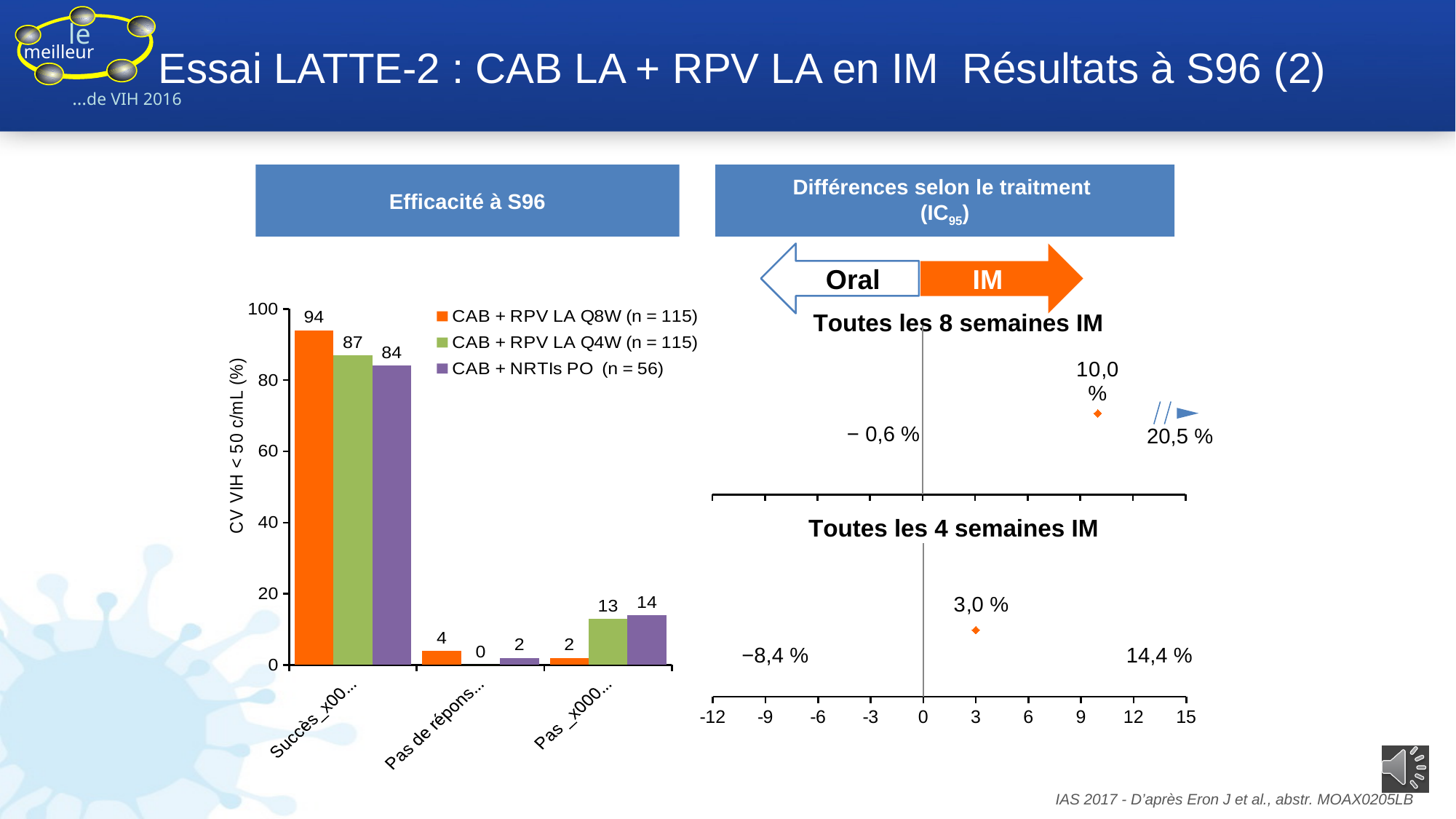
On the 'Efficacité à S96' chart, how many series does the legend list? 3 On the 'Différences selon le traitment' chart, what is the lower bound of the confidence interval for 'Toutes les 4 semaines IM'? −8,4 % On the 'Efficacité à S96' chart, what is the value for CAB + NRTIs PO (n = 56) in the first category (Succès)? 84 On the 'Efficacité à S96' chart, what is the value for CAB + RPV LA Q8W (n = 115) in the first category (Succès)? 94 On the 'Efficacité à S96' chart, how many categories are shown on the x axis? 3 On the 'Efficacité à S96' chart, what is the value for CAB + RPV LA Q4W (n = 115) in the second category (Pas de répons...)? 0 On the 'Efficacité à S96' chart, which series has the highest value in the first category (Succès)? CAB + RPV LA Q8W (n = 115) On the 'Efficacité à S96' chart, what colour represents CAB + RPV LA Q8W (n = 115) in the legend? orange On the 'Efficacité à S96' chart, what is the difference between CAB + RPV LA Q8W and CAB + RPV LA Q4W in the first category (Succès)? 7 On the 'Efficacité à S96' chart, in the third category, which is larger: CAB + RPV LA Q4W or CAB + NRTIs PO? CAB + NRTIs PO On the 'Différences selon le traitment' chart, what is the point estimate for 'Toutes les 8 semaines IM'? 10,0 % On the 'Efficacité à S96' chart, what kind of chart is shown? bar chart